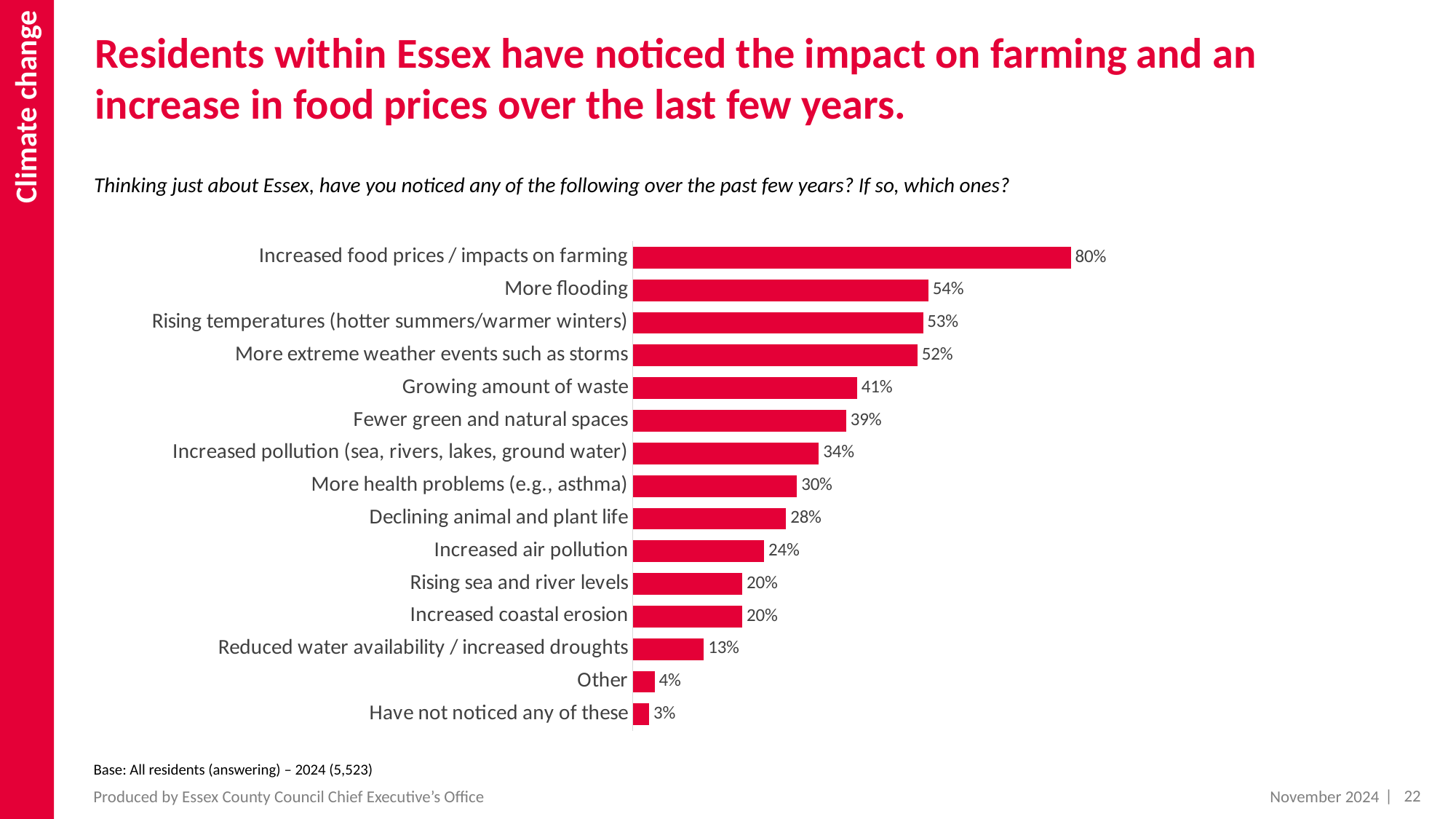
What percentage of residents noticed increased food prices / impacts on farming? 80% Which is larger: 'Increased pollution (sea, rivers, lakes, ground water)' or 'Increased air pollution'? Increased pollution (sea, rivers, lakes, ground water) What percentage of residents noticed a growing amount of waste? 41% What colour are the bars in the chart? Red What is the difference between 'Increased food prices / impacts on farming' and 'More flooding'? 26 percentage points What is the value for 'Reduced water availability / increased droughts'? 13% How many categories are shown in the chart? 15 Which category has the highest value? Increased food prices / impacts on farming What is the value for 'More flooding'? 54% What is the difference between 'Growing amount of waste' and 'Fewer green and natural spaces'? 2 percentage points Which category has the lowest value? Have not noticed any of these What kind of chart is shown on the slide? Bar chart